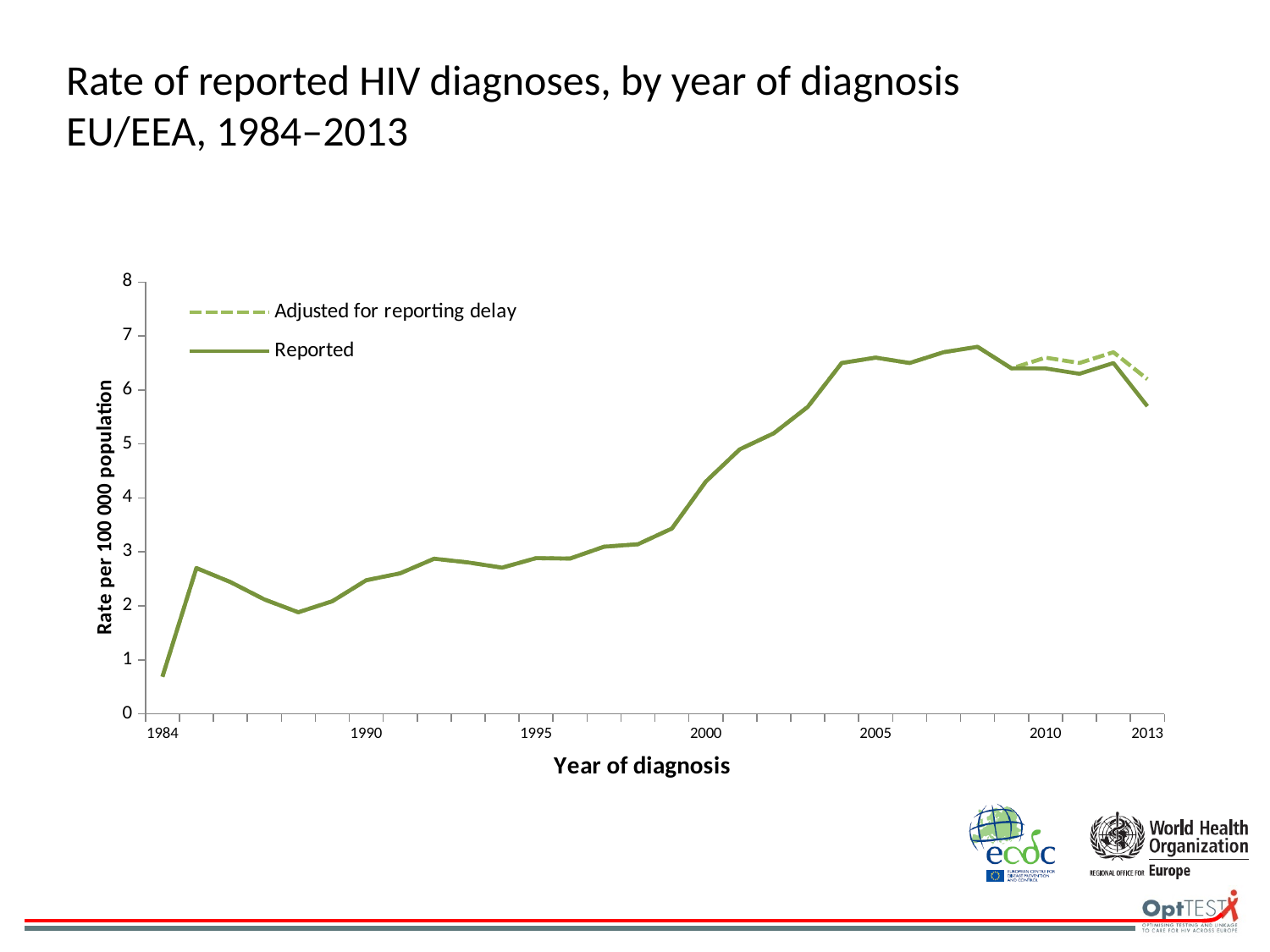
What is the title of the vertical axis? Rate per 100 000 population In which year is the Reported rate lowest? 1984 Is the Reported value for 1990 greater or less than 2? greater Is the Reported value for 2005 greater or less than 6? greater What kind of chart is shown on the slide? line chart Is the Reported value for 1984 greater or less than 1? less How many series does the legend list? 2 Which year has the higher Reported rate, 1984 or 2013? 2013 Does the Reported rate rise or fall between 1999 and 2004? rise What are the two series named in the legend? Adjusted for reporting delay; Reported